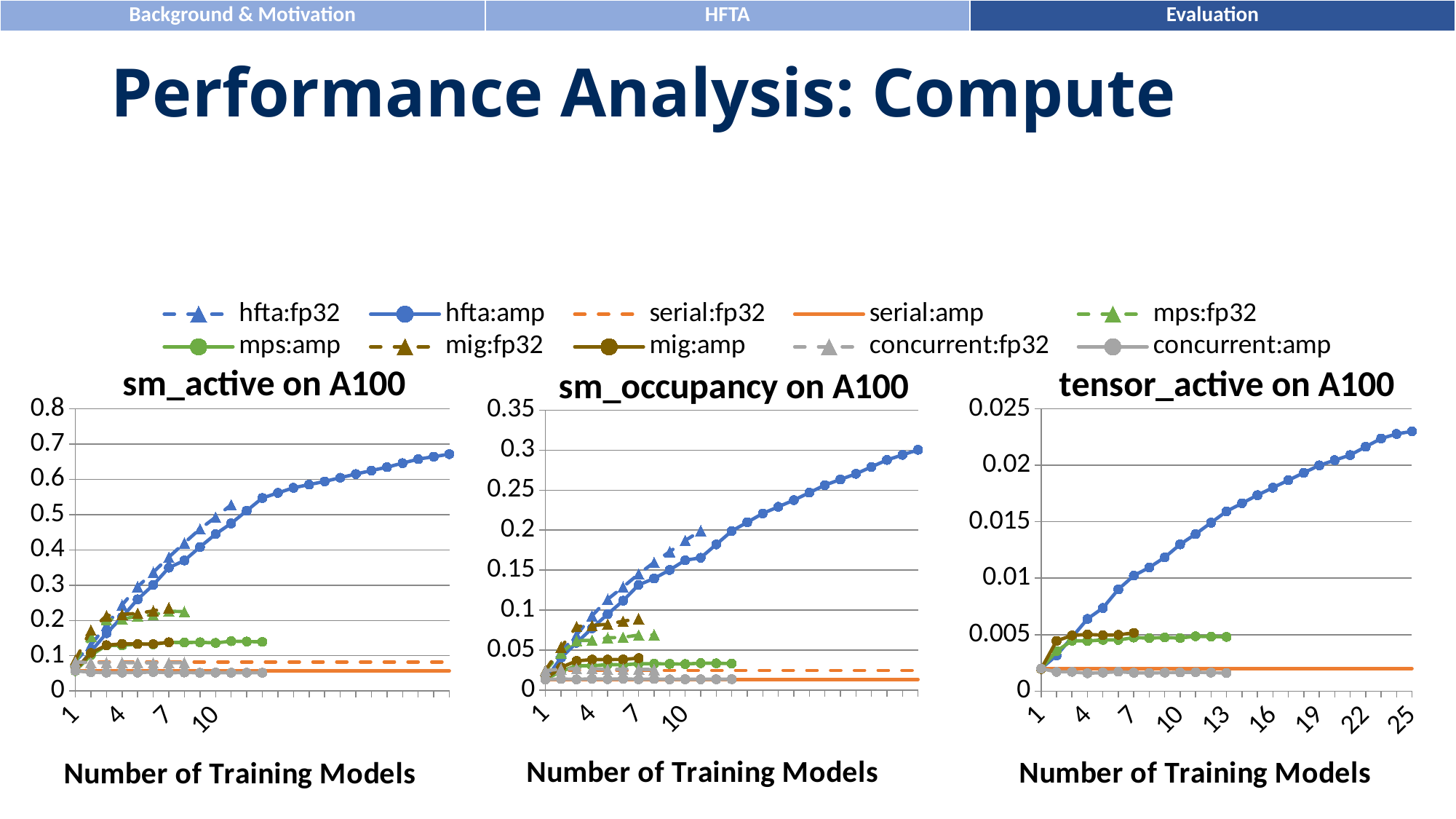
In the "sm_occupancy on A100" chart, is the value for serial:fp32 greater or less than 0.05? less In the "sm_active on A100" chart, does the hfta:amp series rise or fall as the number of training models increases? rise In the "sm_occupancy on A100" chart, is the value for hfta:amp at 25 training models greater or less than 0.25? greater In the "sm_active on A100" chart, is the value for serial:amp greater or less than 0.1? less What is the title of the rightmost chart on the slide? tensor_active on A100 How many series does the shared legend list for the charts on this slide? 10 What kind of chart is "sm_active on A100"? line chart What is the x-axis label of the "sm_occupancy on A100" chart? Number of Training Models In the "tensor_active on A100" chart, which series is larger at 25 training models, hfta:amp or serial:amp? hfta:amp